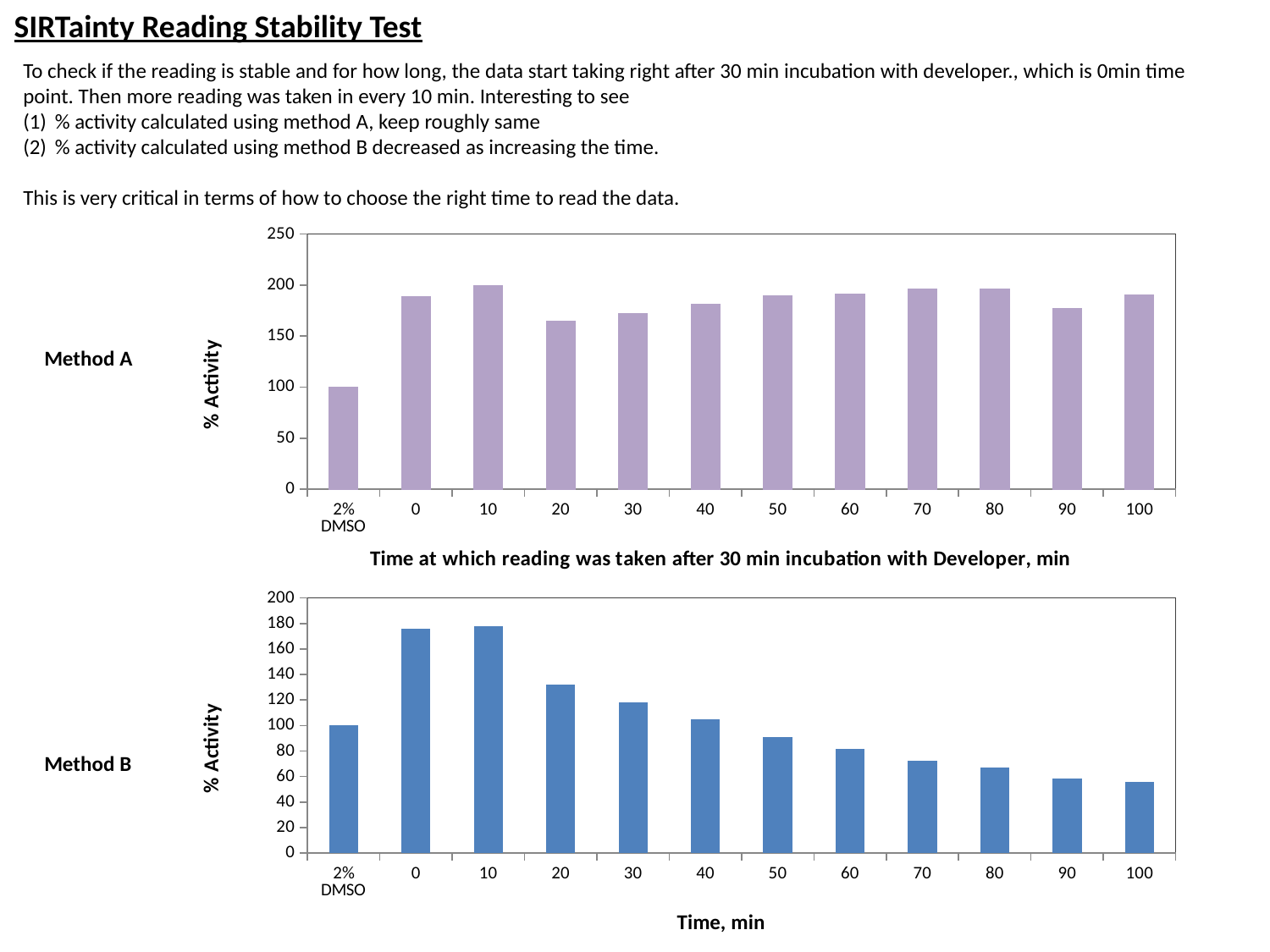
In the Method B chart, which is larger, the value at 20 min or the value at 60 min? 20 min In the Method B chart, is the value at 20 min greater or less than 120? greater In the Method B chart, is the value at 100 min greater or less than 80? less In the Method B chart, is the value at 50 min greater or less than 100? less How many bars (categories) are plotted in the Method B chart at the bottom of the slide? 12 In the Method B chart, do the values rise or fall from 10 min to 100 min? fall In the Method A chart, which category has the lowest % Activity? 2% DMSO In the Method A chart, what is the % Activity value for 2% DMSO? 100 What is the x-axis title of the Method B chart at the bottom of the slide? Time, min What type of chart is the Method A chart at the top of the slide? bar chart In the Method B chart, what is the % Activity value for 2% DMSO? 100